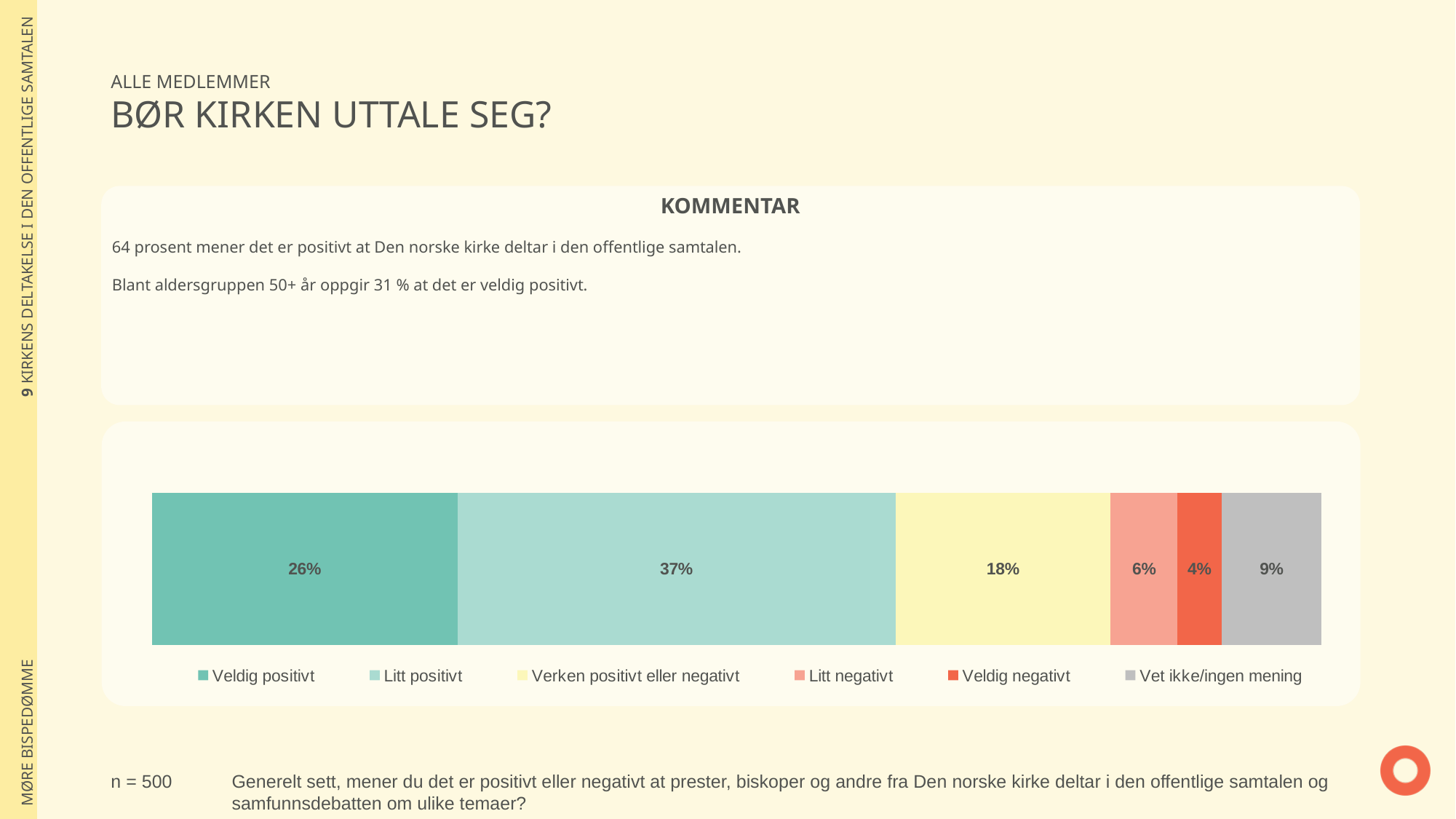
What percentage of respondents answered "Litt positivt"? 37% What colour is the segment for "Veldig negativt"? Red/orange What percentage of respondents answered "Veldig positivt"? 26% What percentage of respondents answered "Vet ikke/ingen mening"? 9% What type of chart is shown on the slide? Stacked bar chart How many response categories does the legend list? 6 What is the combined share of "Veldig positivt" and "Litt positivt"? 63% What is the difference in percentage points between "Litt positivt" and "Veldig positivt"? 11 Which response category has the largest share? Litt positivt What percentage of respondents answered "Verken positivt eller negativt"? 18% Which is larger, the share for "Litt negativt" or the share for "Vet ikke/ingen mening"? Vet ikke/ingen mening Which response category has the smallest share? Veldig negativt